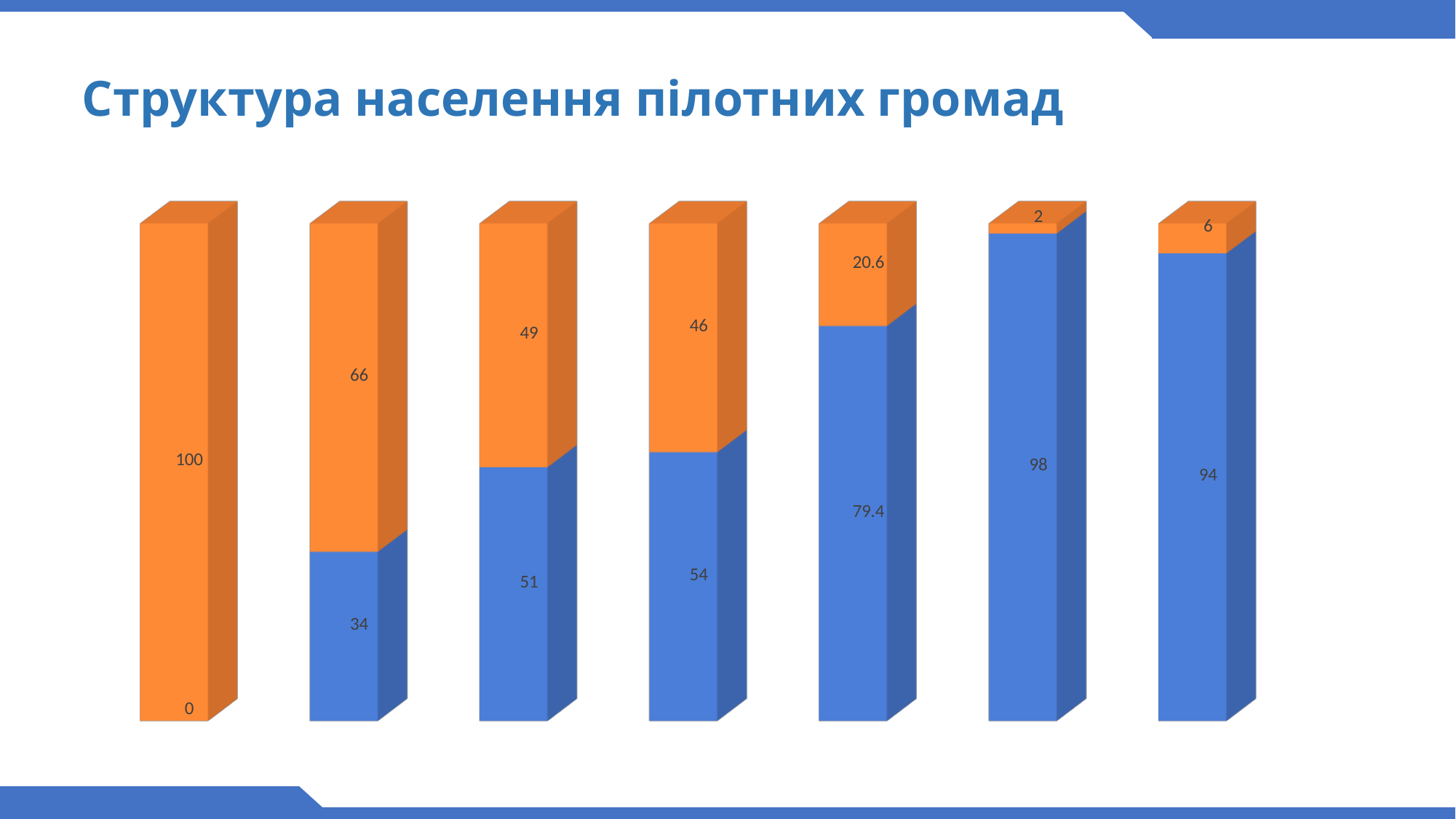
What kind of chart is shown on the slide? Stacked bar chart What is the value of the orange segment in the leftmost bar? 100 In the fourth bar from the left, which segment is larger, the blue or the orange? Blue How many bars are plotted in the chart? 7 Which bar has the largest blue segment? The sixth bar from the left (98) What is the value of the blue segment in the second bar from the left? 34 What is the value of the orange segment in the fifth bar from the left? 20.6 What is the total of the stacked segments in the third bar from the left? 100 What is the value of the blue segment in the rightmost bar? 94 Which bar has the smallest orange segment? The sixth bar from the left (2) What is the difference between the orange and blue segments in the second bar from the left? 32 What is the title of the chart on the slide? Структура населення пілотних громад